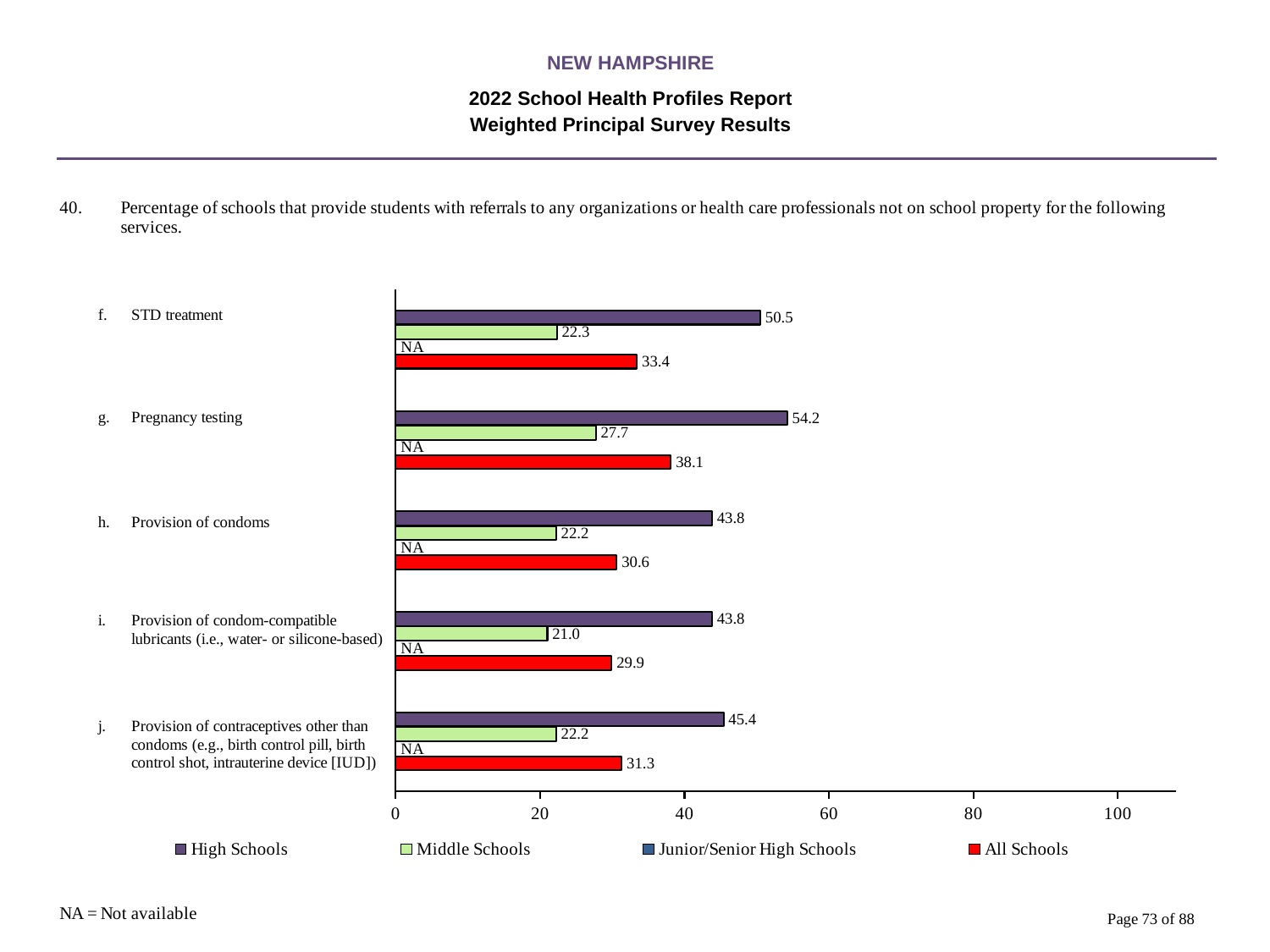
What is the High Schools value for Pregnancy testing? 54.2 What is the Junior/Senior High Schools value for STD treatment? NA Which service has the lowest All Schools value? Provision of condom-compatible lubricants How many services (categories) are shown on the chart? 5 What is the Middle Schools value for Provision of condom-compatible lubricants? 21.0 What is the All Schools value for Provision of condoms? 30.6 How many series does the legend list? 4 Which legend entry is shown in red? All Schools Which is larger: the All Schools value for Pregnancy testing or the All Schools value for Provision of contraceptives other than condoms? Pregnancy testing What is the difference between the High Schools and Middle Schools values for STD treatment? 28.2 What kind of chart is shown on the slide? Bar chart Which service has the highest High Schools value? Pregnancy testing